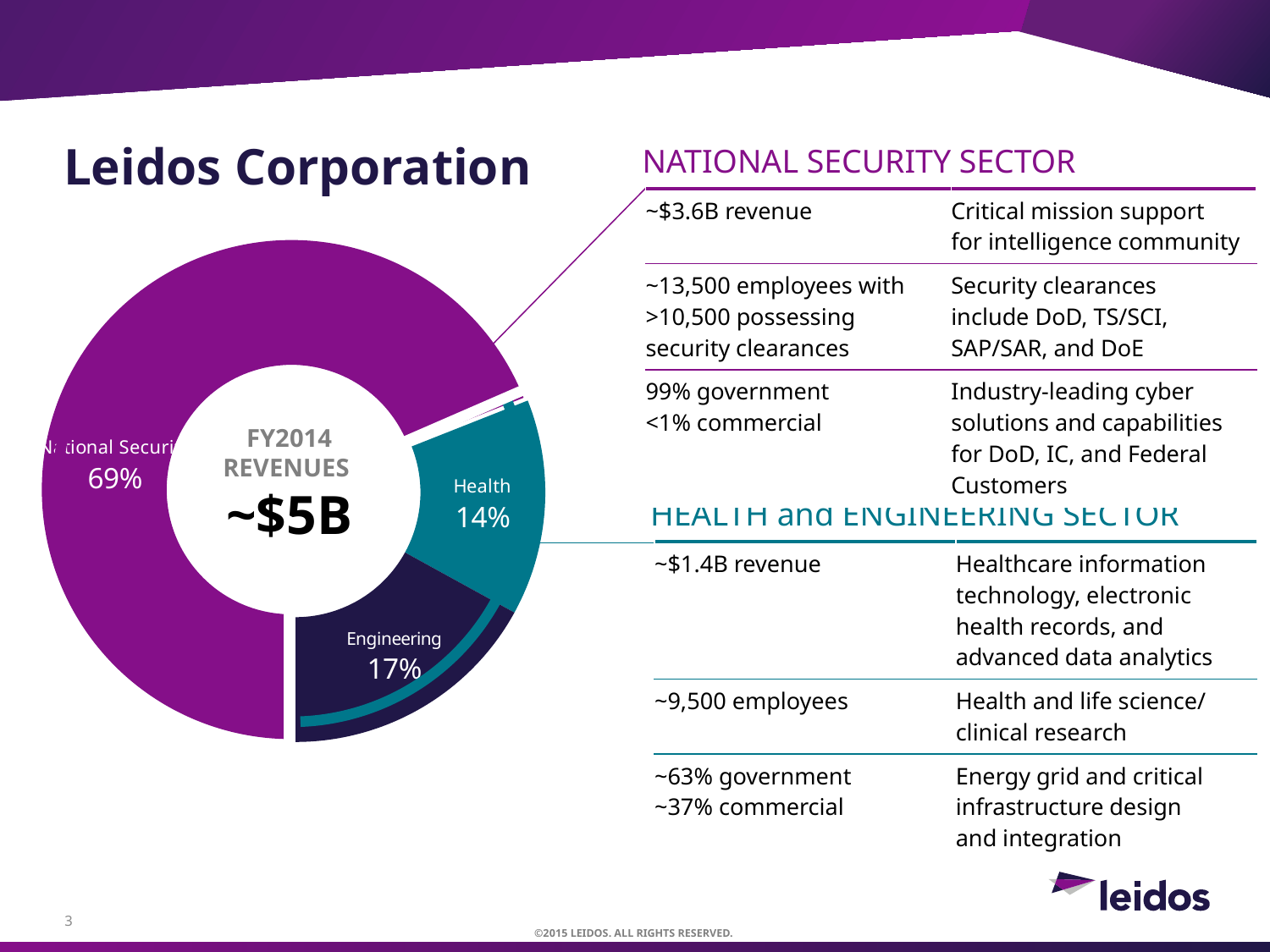
What total FY2014 revenue figure is shown in the center of the donut chart? ~$5B What fiscal year does the donut chart's revenue breakdown refer to? FY2014 What percentage of FY2014 revenues does the National Security slice represent? 69% Which slice of the donut chart is the largest? National Security What percentage of FY2014 revenues does the Health slice represent? 14% What kind of chart is shown on the slide? Donut (pie) chart What is the difference in percentage points between the Engineering and Health slices? 3 percentage points Which slice of the donut chart is the smallest? Health Which is larger in the donut chart, Engineering or Health? Engineering What is the difference in percentage points between the National Security and Engineering slices? 52 percentage points How many slices does the donut chart have? 3 What percentage of FY2014 revenues does the Engineering slice represent? 17%